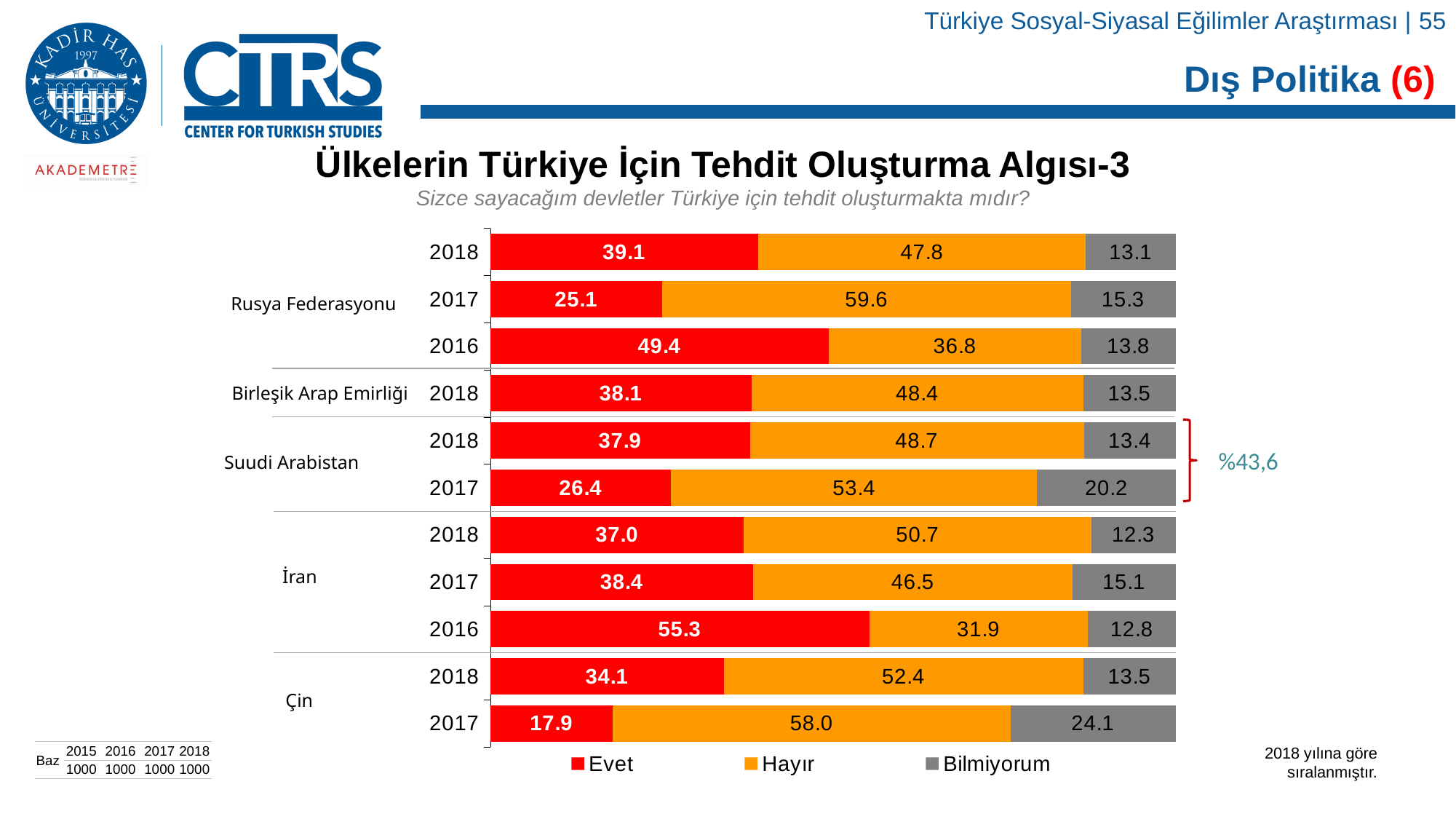
What is the difference between the Evet values for Rusya Federasyonu in 2018 and 2017? 14.0 Which bar has the highest Evet value? İran 2016 Which colour represents the Bilmiyorum series in the chart? Grey What is the Evet value for Rusya Federasyonu in 2018? 39.1 What is the Hayır value for Çin in 2017? 58.0 What is the total of the stacked bar for Birleşik Arap Emirliği in 2018? 100.0 What is the Bilmiyorum value for Suudi Arabistan in 2017? 20.2 How many bars are shown in the chart? 11 What kind of chart is shown on the slide? Stacked bar chart Which is larger, the Hayır value for İran in 2018 or for İran in 2017? İran 2018 How many series does the legend list? 3 Which bar has the lowest Evet value? Çin 2017